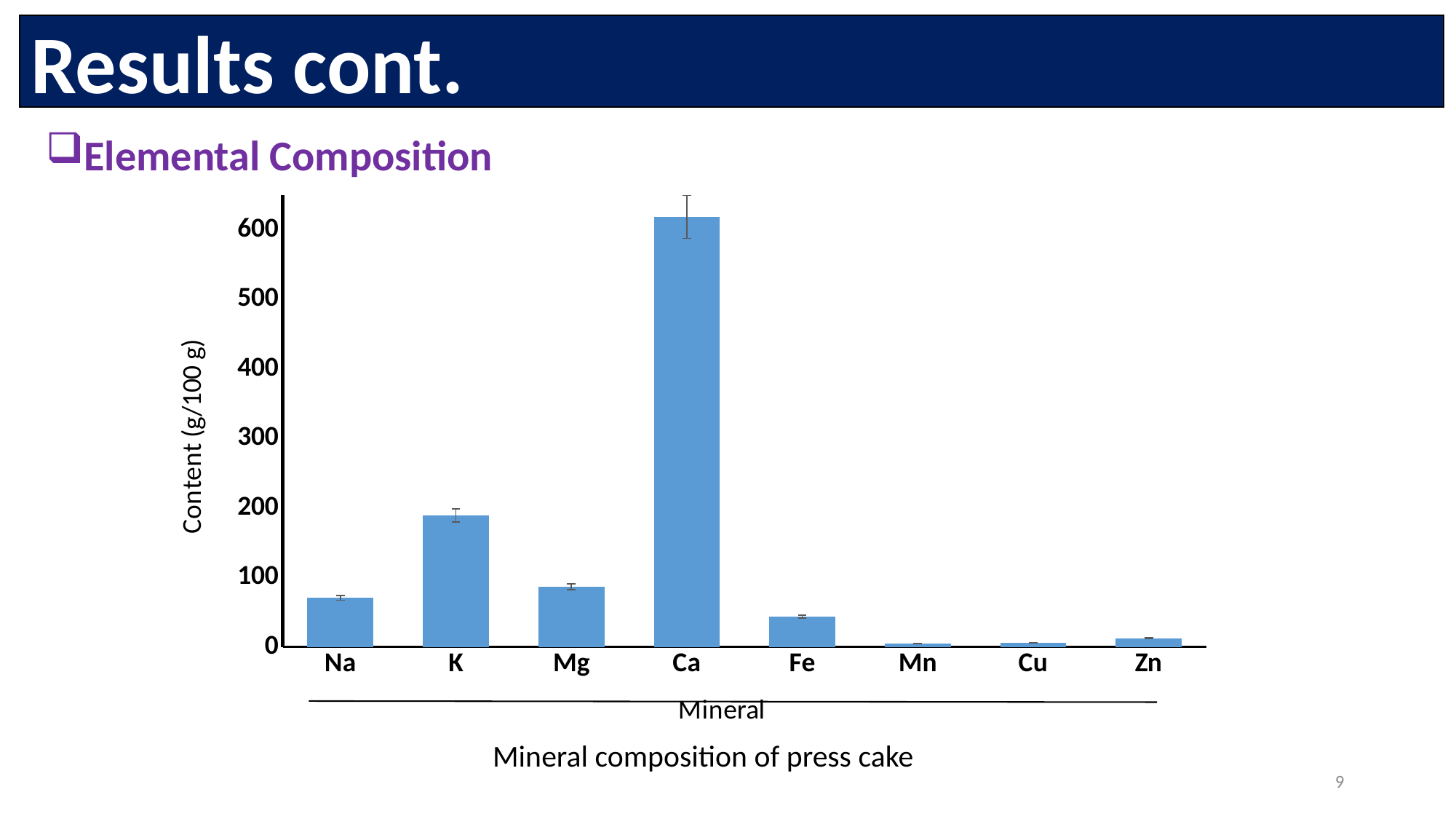
Which has the higher content, Mg or Na? Mg What is the label of the y axis? Content (g/100 g) What caption appears below the chart? Mineral composition of press cake Which has the higher content, K or Mg? K Is the value for Ca greater or less than 500? greater Is the value for K greater or less than 100? greater Is the value for Mg greater or less than 100? less Which has the higher content, Na or Fe? Na How many minerals are plotted on the x axis? 8 Which mineral has the highest content? Ca What kind of chart is shown on the slide? bar chart